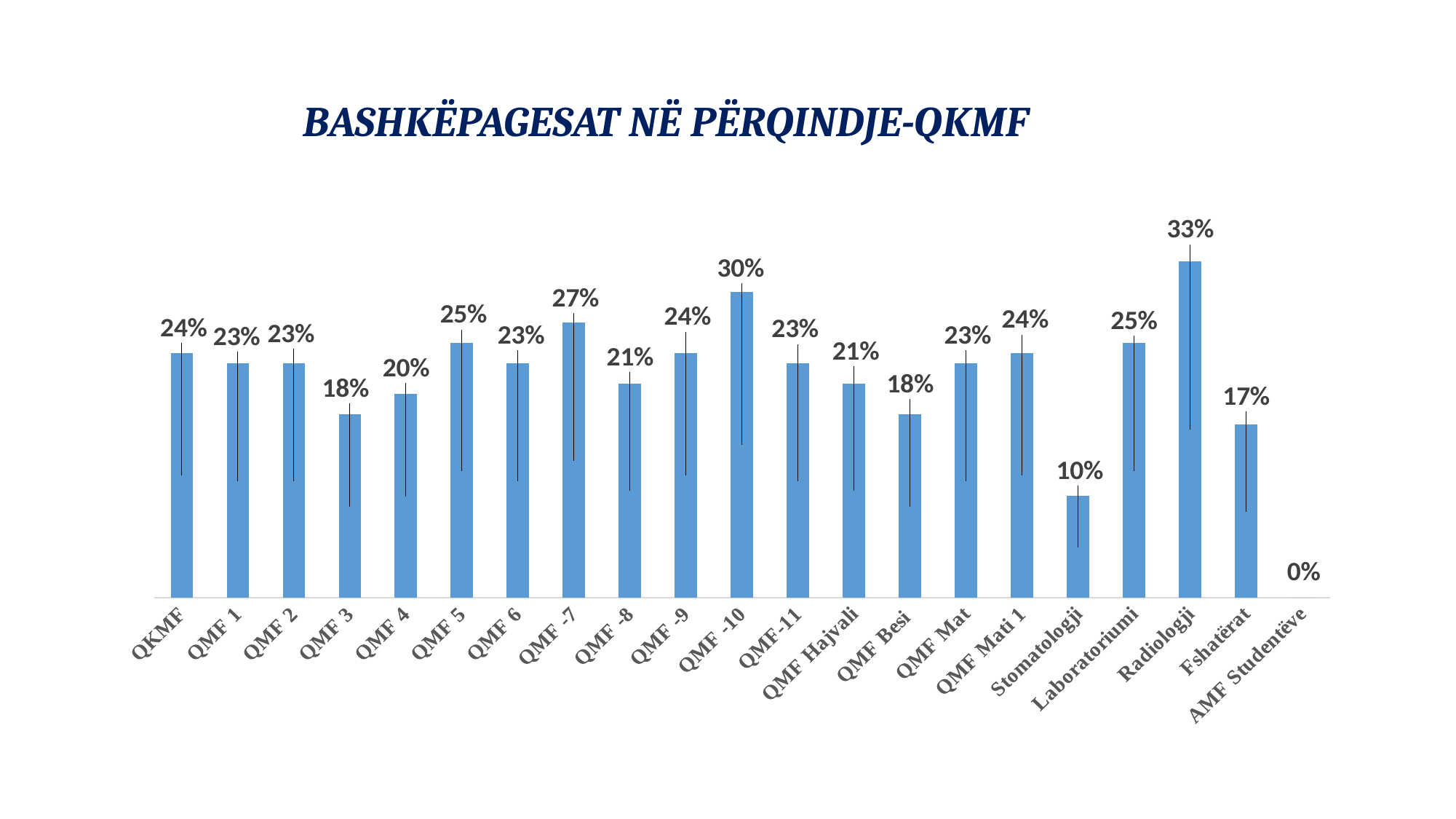
What is the value for QMF -10? 30% What is the value for Radiologji? 33% Which category has the highest value? Radiologji What is the value for Stomatologji? 10% What is the difference between the values for Radiologji and Stomatologji? 23% Which is larger, the value for QMF -7 or the value for QMF 4? QMF -7 How many categories are shown on the x axis? 21 What kind of chart is shown on the slide? Bar chart What is the value for Fshatërat? 17% Which category has the lowest value? AMF Studentëve What is the difference between the values for QMF -10 and QMF 3? 12% What is the title of the chart? BASHKËPAGESAT NË PËRQINDJE-QKMF